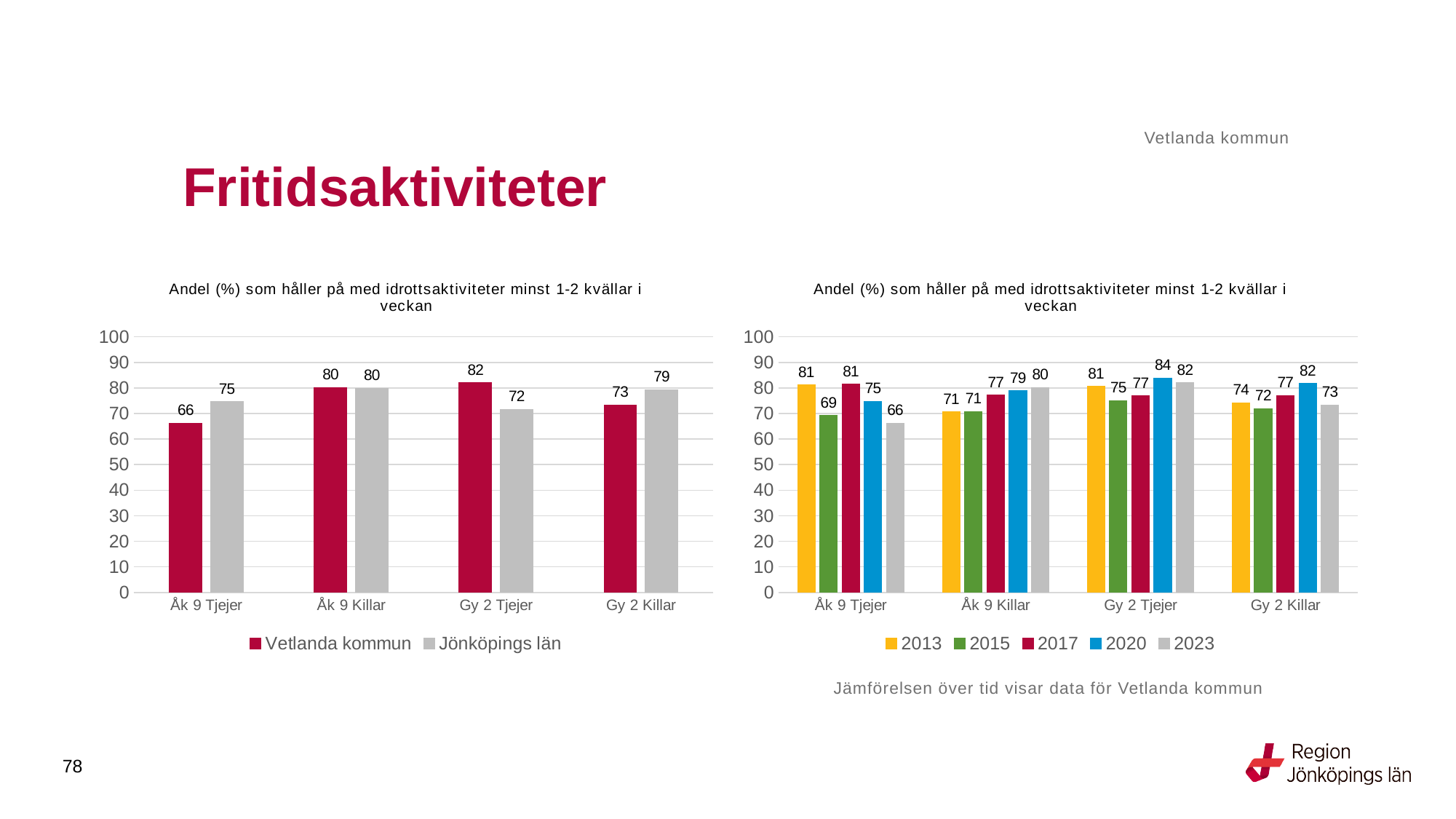
In the right chart, what is the value for 2023 for Åk 9 Tjejer? 66 What kind of chart is the right chart? Bar chart In the left chart, which is larger for Åk 9 Tjejer: Vetlanda kommun or Jönköpings län? Jönköpings län In the right chart, how many series does the legend list? 5 In the right chart, which year has the lowest value for Åk 9 Tjejer? 2023 In the left chart, how many series does the legend list? 2 In the right chart, what is the difference between 2013 and 2015 for Åk 9 Tjejer? 12 In the left chart, what is the value for Jönköpings län for Gy 2 Killar? 79 In the left chart, what is the difference between Vetlanda kommun and Jönköpings län for Gy 2 Tjejer? 10 In the left chart, what is the value for Vetlanda kommun for Åk 9 Tjejer? 66 In the left chart, which category has the highest value for Vetlanda kommun? Gy 2 Tjejer In the right chart, what is the value for 2020 for Gy 2 Tjejer? 84